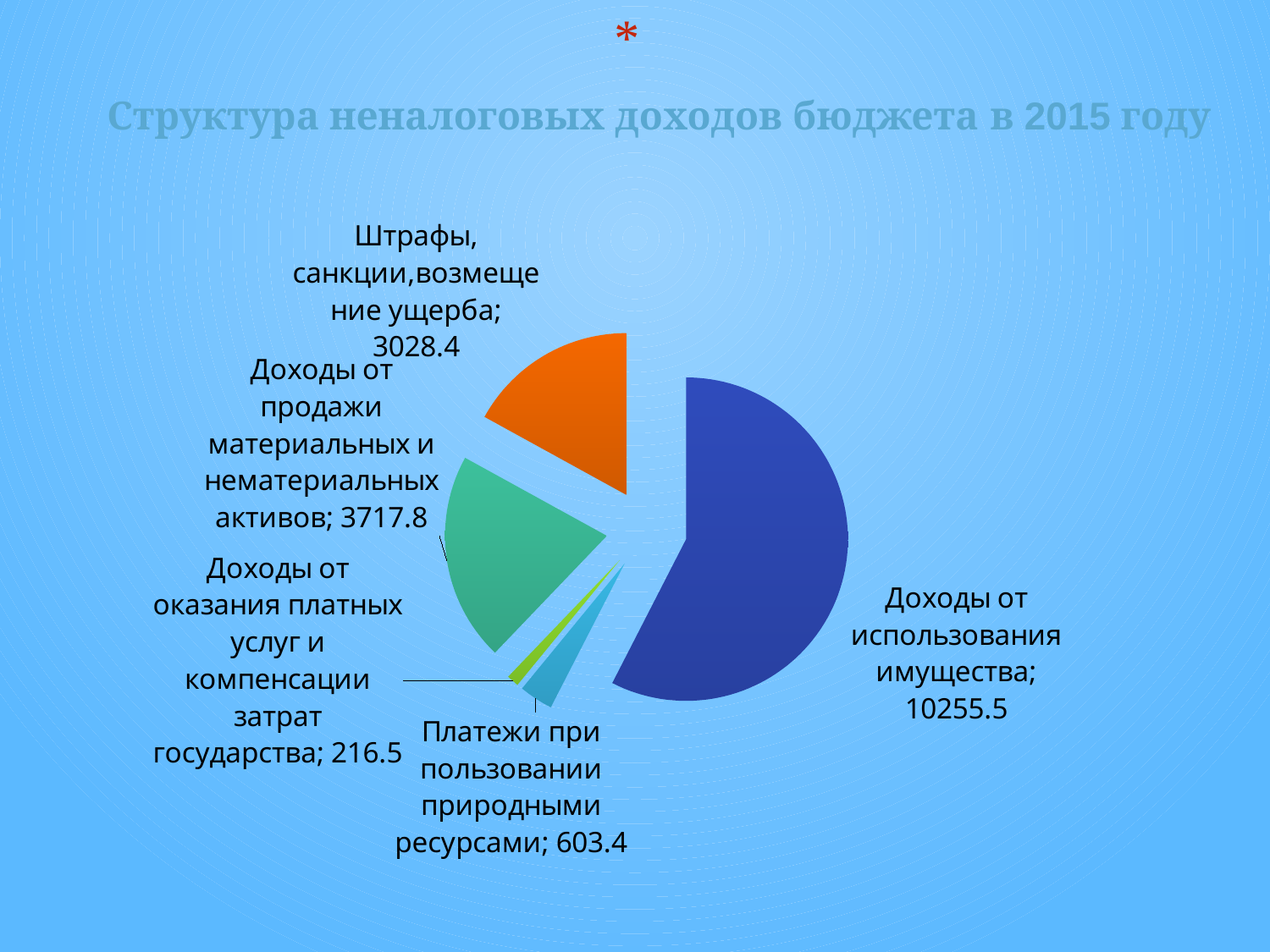
What is the value for Штрафы, санкции, возмещение ущерба? 3028.4 How many slices does the pie chart have? 5 Which category has the largest slice of the pie? Доходы от использования имущества What kind of chart is shown on the slide? Pie chart Which is larger: Платежи при пользовании природными ресурсами or Доходы от оказания платных услуг и компенсации затрат государства? Платежи при пользовании природными ресурсами What is the value for Платежи при пользовании природными ресурсами? 603.4 What is the difference between Доходы от продажи материальных и нематериальных активов and Штрафы, санкции, возмещение ущерба? 689.4 Which category has the smallest slice of the pie? Доходы от оказания платных услуг и компенсации затрат государства What is the title of the slide? Структура неналоговых доходов бюджета в 2015 году What is the value for Доходы от оказания платных услуг и компенсации затрат государства? 216.5 What is the value for Доходы от использования имущества? 10255.5 What is the difference between Доходы от использования имущества and Доходы от продажи материальных и нематериальных активов? 6537.7